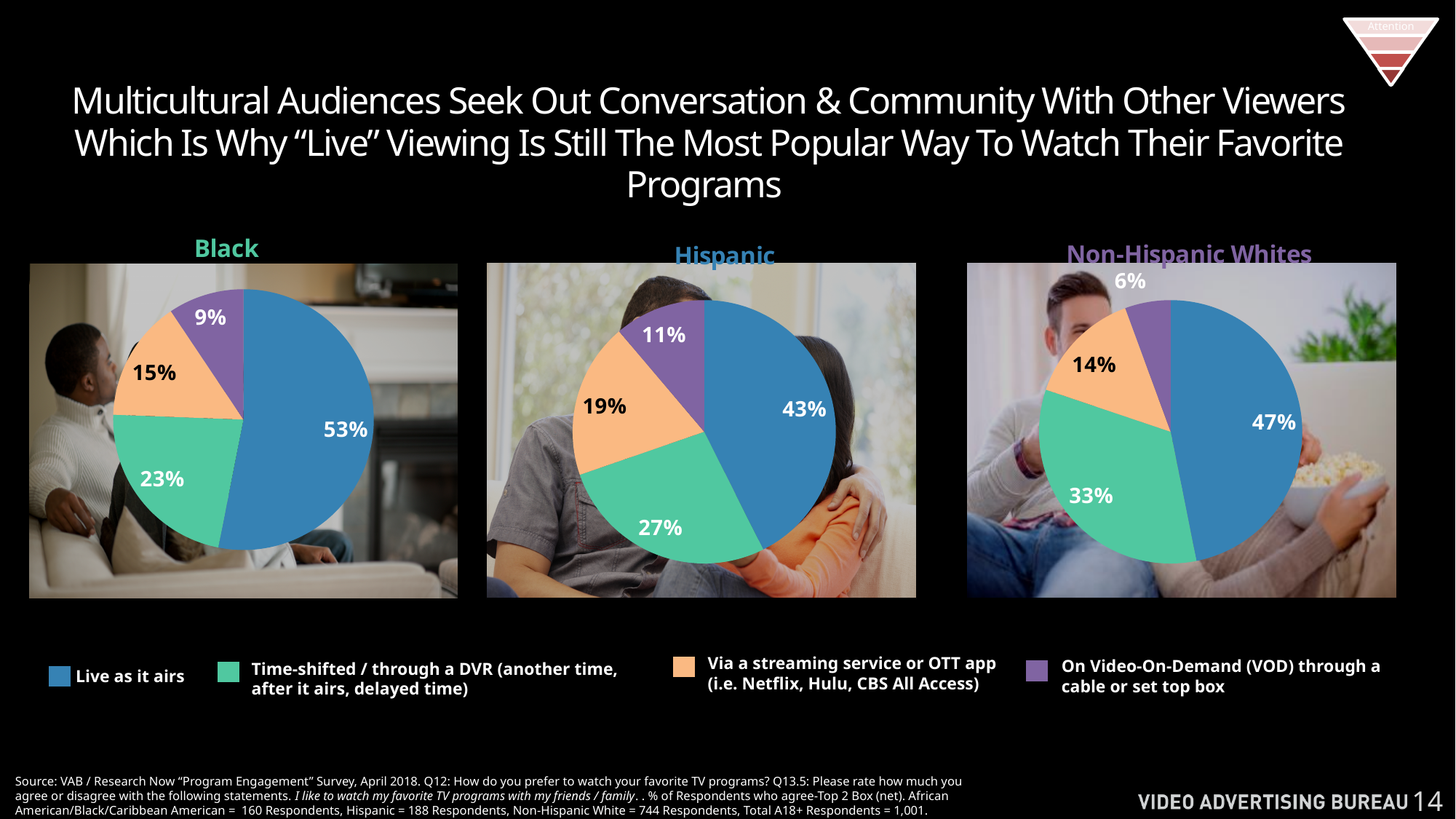
In the Black pie chart, what share of respondents prefer to watch live as it airs? 53% What is the difference between the live-as-it-airs share in the Black chart and the live-as-it-airs share in the Hispanic chart? 10 percentage points How many viewing methods does the legend list? 4 In the Non-Hispanic Whites pie chart, which viewing method has the smallest share? On Video-On-Demand (VOD) through a cable or set top box Which group has a larger time-shifted / DVR share: Black or Non-Hispanic Whites? Non-Hispanic Whites In the Non-Hispanic Whites pie chart, what share of respondents prefer Video-On-Demand through a cable or set top box? 6% Which colour represents 'Live as it airs' in the pie charts? Blue In the Hispanic pie chart, what share of respondents prefer time-shifted / DVR viewing? 27% In the Hispanic pie chart, what share of respondents prefer a streaming service or OTT app? 19% What type of chart is used to show the viewing preferences for each group? Pie chart In the Black pie chart, which viewing method has the largest share? Live as it airs How many slices does each pie chart on the slide have? 4